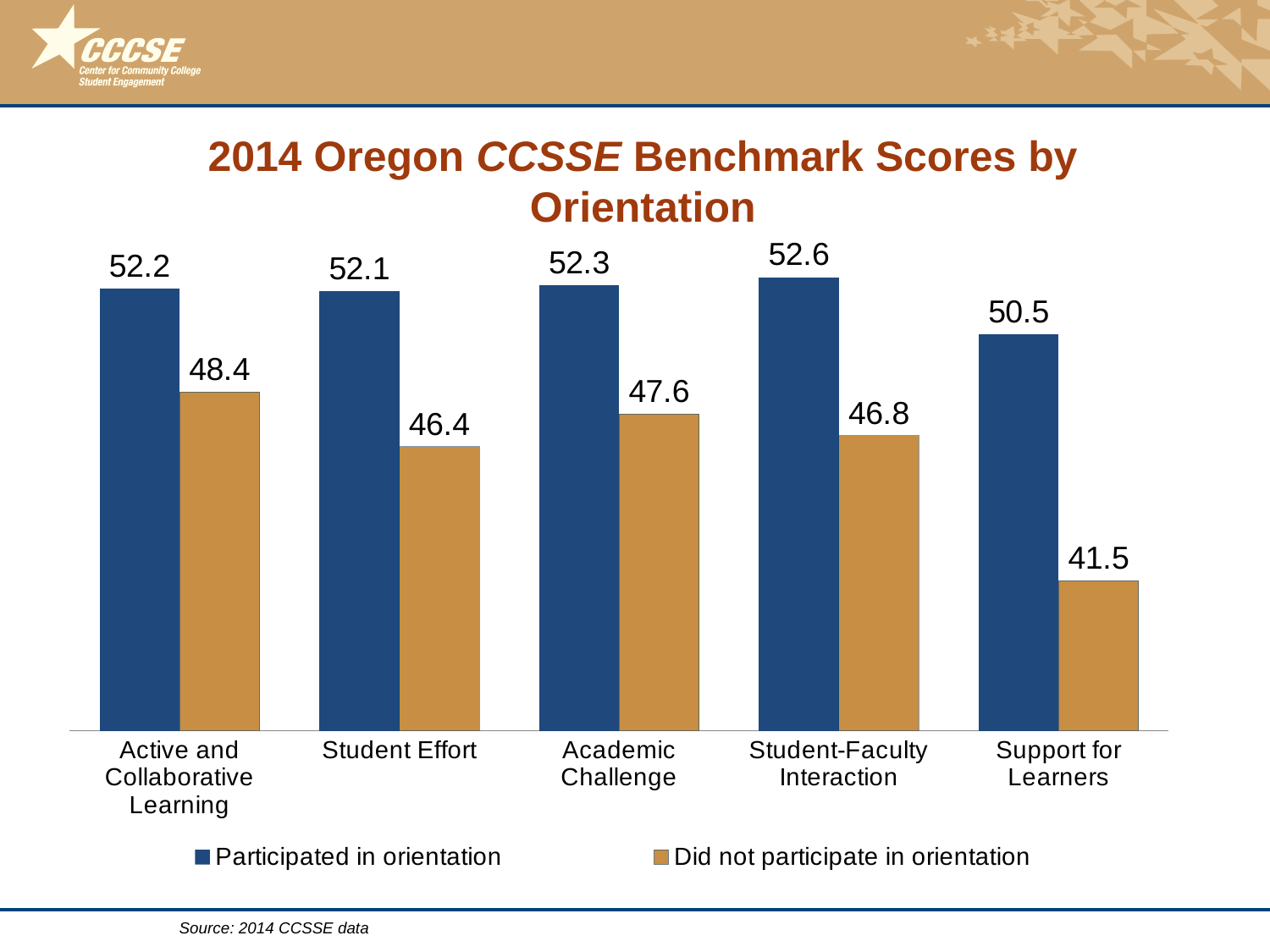
How many benchmark categories are shown on the x axis? 5 What is the benchmark score for Student Effort among students who participated in orientation? 52.1 Which benchmark has the highest score for students who participated in orientation? Student-Faculty Interaction What is the difference between the participated and did-not-participate scores for Support for Learners? 9.0 Which benchmark has the lowest score for students who did not participate in orientation? Support for Learners What is the benchmark score for Academic Challenge among students who did not participate in orientation? 47.6 How many series does the legend list? 2 For Student-Faculty Interaction, which group has the higher score: participated in orientation or did not participate in orientation? Participated in orientation What is the difference between the participated and did-not-participate scores for Active and Collaborative Learning? 3.8 What colour are the bars for students who did not participate in orientation? Orange/gold What kind of chart is shown on the slide? Bar chart What is the benchmark score for Support for Learners among students who did not participate in orientation? 41.5